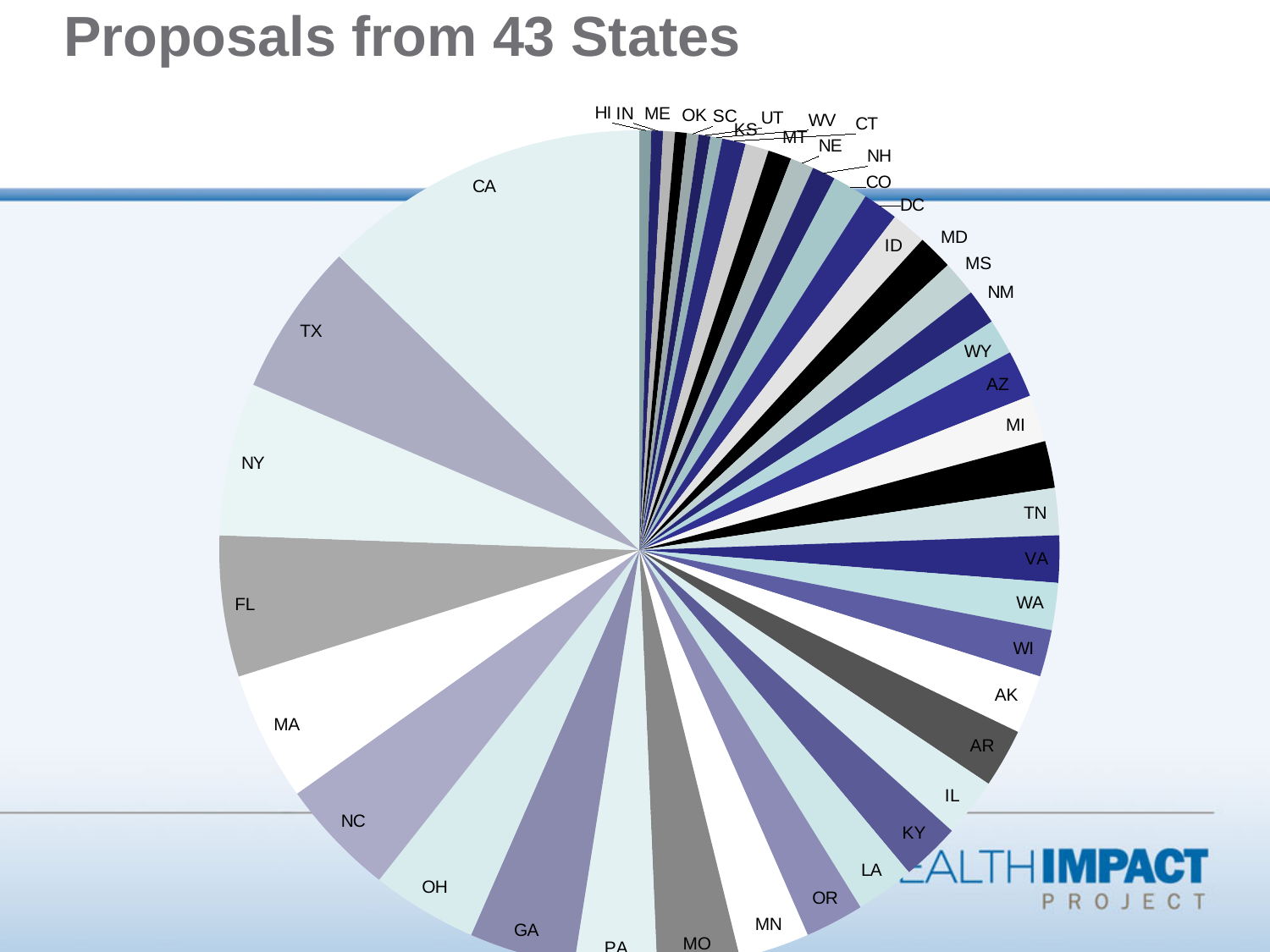
Which slice is larger, TX or DC? TX Which state has the largest slice of the pie? CA Which slice is larger, MA or ME? MA Which slice is larger, HI or NY? NY What kind of chart is shown on the slide? pie chart What is the title of the slide containing the pie chart? Proposals from 43 States According to the slide title, proposals came from how many states? 43